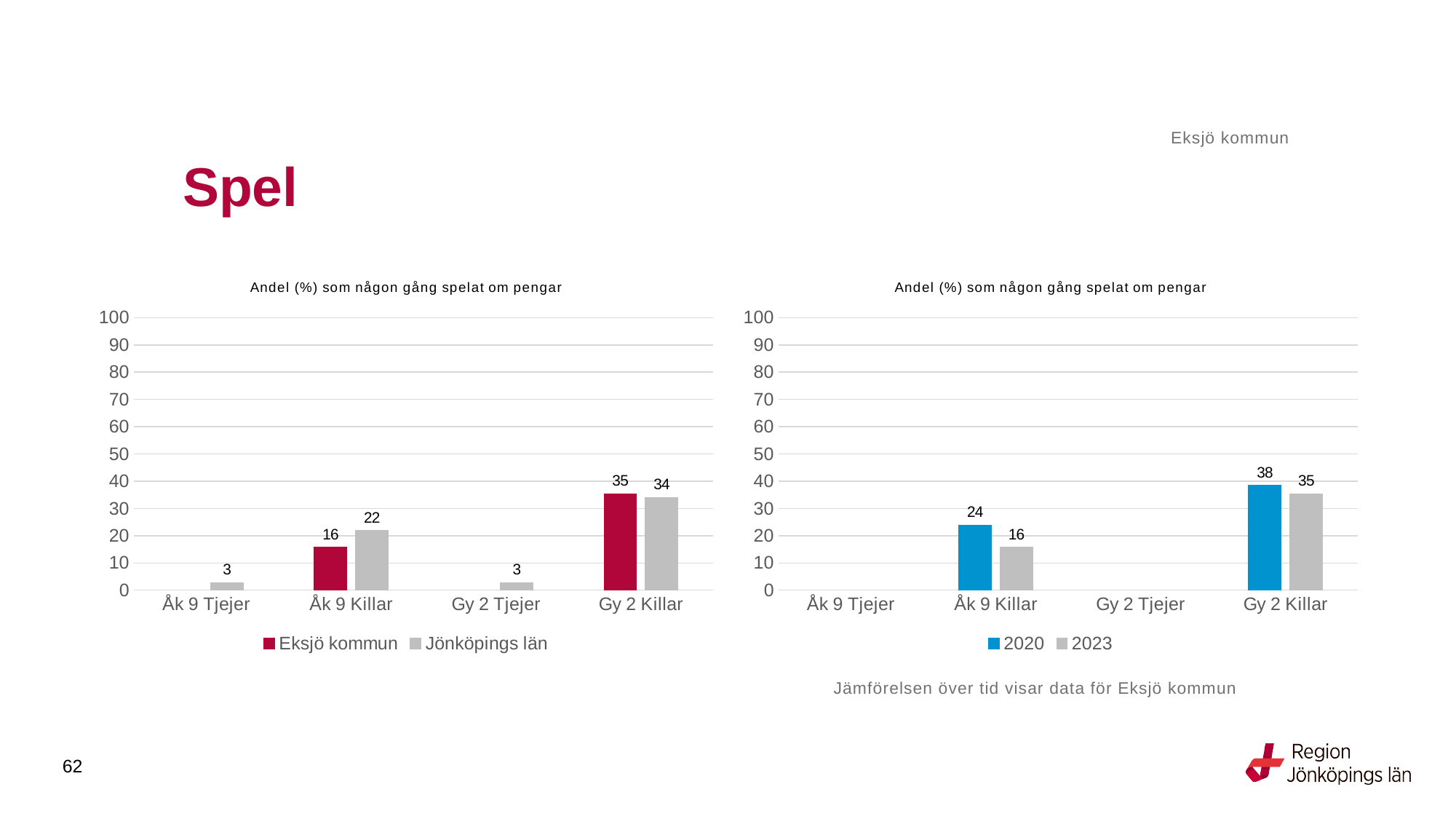
In the left chart, what is the value for Eksjö kommun for Gy 2 Killar? 35 In the left chart, what is the difference between Jönköpings län and Eksjö kommun for Åk 9 Killar? 6 In the left chart, which category has the highest value for Jönköpings län? Gy 2 Killar What kind of chart is the right chart? bar chart In the left chart, what is the value for Jönköpings län for Åk 9 Killar? 22 In the left chart, how many series does the legend list? 2 In the right chart, what is the value for 2020 for Gy 2 Killar? 38 How many categories are shown on the x axis of the left chart? 4 In the right chart, what is the difference between 2020 and 2023 for Åk 9 Killar? 8 In the right chart, what is the value for 2023 for Åk 9 Killar? 16 In the left chart, what is the value for Jönköpings län for Gy 2 Tjejer? 3 In the right chart, which is larger for Gy 2 Killar, 2020 or 2023? 2020